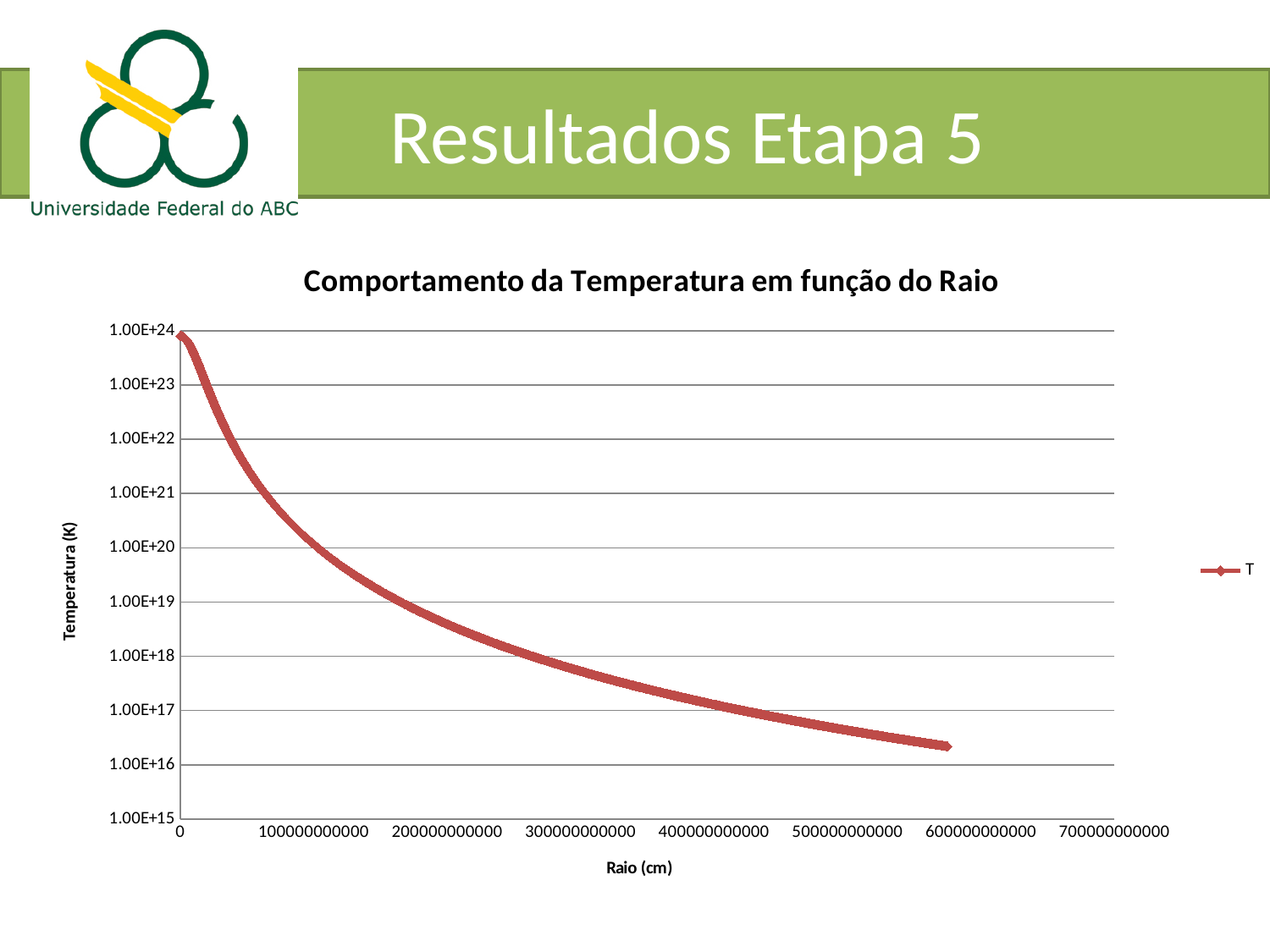
Is the temperature at Raio = 300000000000 cm greater or less than 1.00E+18 K? less What is the title of the chart? Comportamento da Temperatura em função do Raio Is the temperature at Raio = 300000000000 cm greater or less than 1.00E+17 K? greater What is the name of the series shown in the legend? T Does the temperature rise or fall as the radius (Raio) increases along the x axis? fall What kind of chart is shown on the slide? line chart Which is larger: the temperature at Raio = 100000000000 cm or at Raio = 400000000000 cm? Raio = 100000000000 cm Is the temperature at Raio = 500000000000 cm greater or less than 1.00E+17 K? less At which radius value is the temperature highest? 0 How many series does the legend list? 1